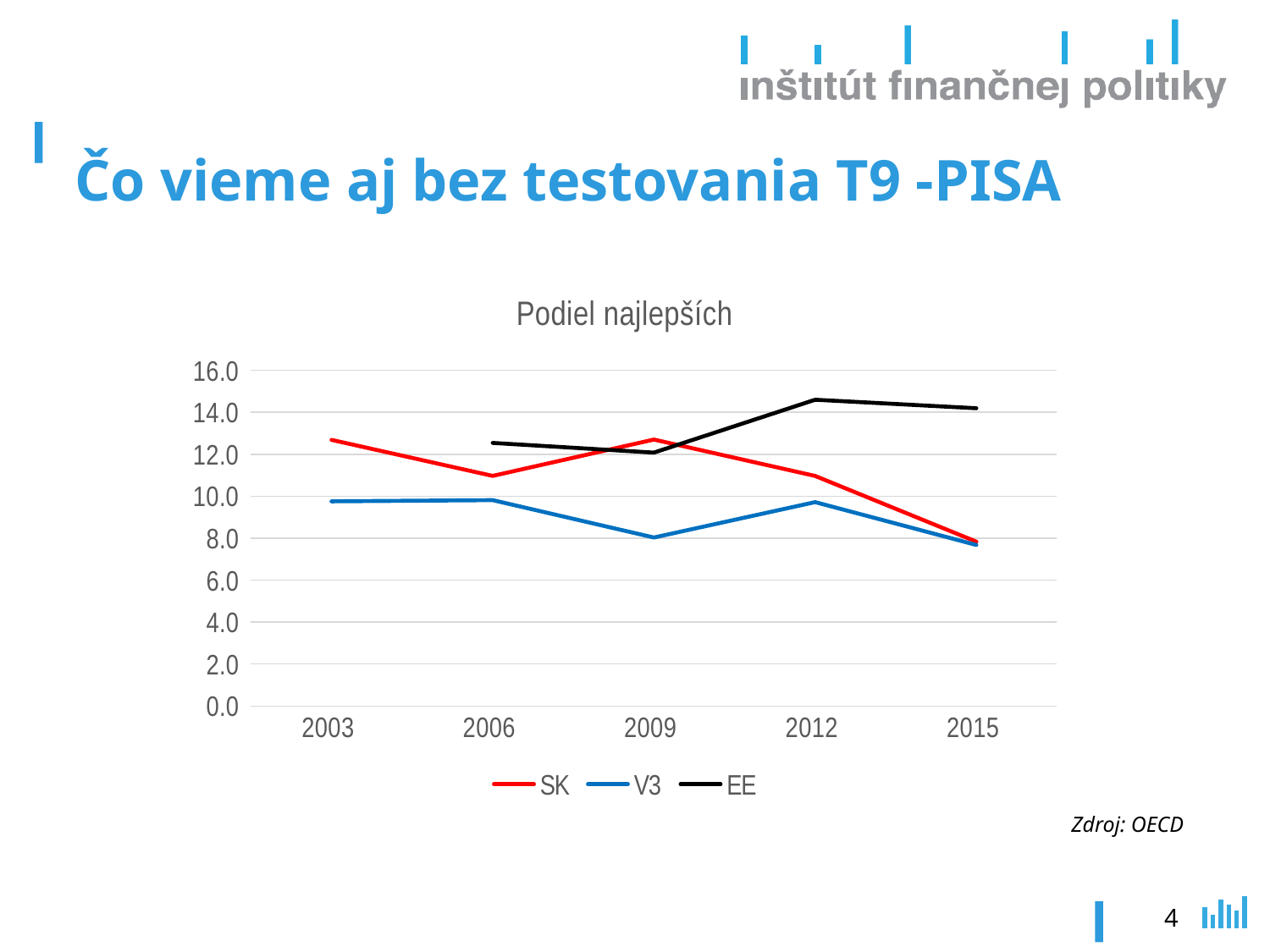
Which series has the highest value in 2015? EE How many years are shown on the x axis of the chart? 5 What is the title of the chart? Podiel najlepších In 2012, which is larger, the value for EE or the value for SK? EE Which colour is used for the EE series in the chart? black Is the value for EE in 2012 greater or less than 14.0? greater Is the value for SK in 2003 greater or less than 12.0? greater Is the value for V3 in 2009 greater or less than 10.0? less Does the SK series rise or fall from 2009 to 2015? fall What kind of chart is shown on the slide? line chart How many series does the legend of the chart list? 3